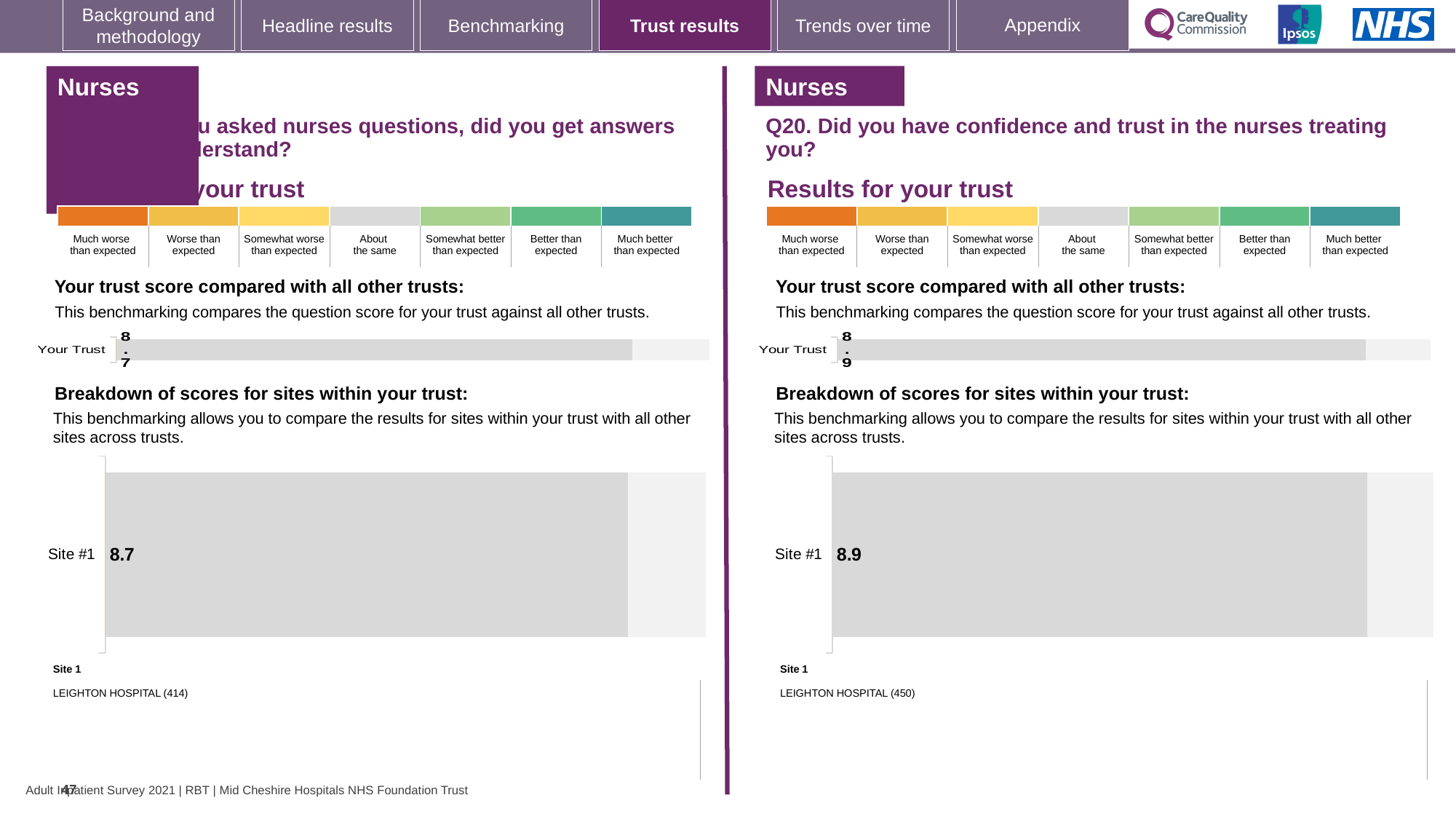
Which is larger: the Your Trust score on the left half of the slide or the Your Trust score on the right half (Q20)? Right half (Q20) How many sites are shown in the left-hand 'Breakdown of scores for sites within your trust' chart? 1 How many sites are shown in the right-hand 'Breakdown of scores for sites within your trust' chart (Q20)? 1 In the right-hand 'Breakdown of scores for sites within your trust' chart (Q20), what is the score for Site #1? 8.9 Which site is listed as Site 1 below the left-hand breakdown chart? LEIGHTON HOSPITAL (414) In the left-hand 'Breakdown of scores for sites within your trust' chart, what is the score for Site #1? 8.7 On the right half of the slide (Q20), what is the score shown for Your Trust? 8.9 Is the Site #1 score on the left half of the slide greater or less than the Site #1 score on the right half (Q20)? less What is the difference between the Site #1 score on the right half (Q20) and the Site #1 score on the left half of the slide? 0.2 Which site is listed as Site 1 below the right-hand breakdown chart (Q20)? LEIGHTON HOSPITAL (450) On the left half of the slide, what is the score shown for Your Trust? 8.7 What kind of chart is used to show the Your Trust score on the right half of the slide (Q20)? Bar chart